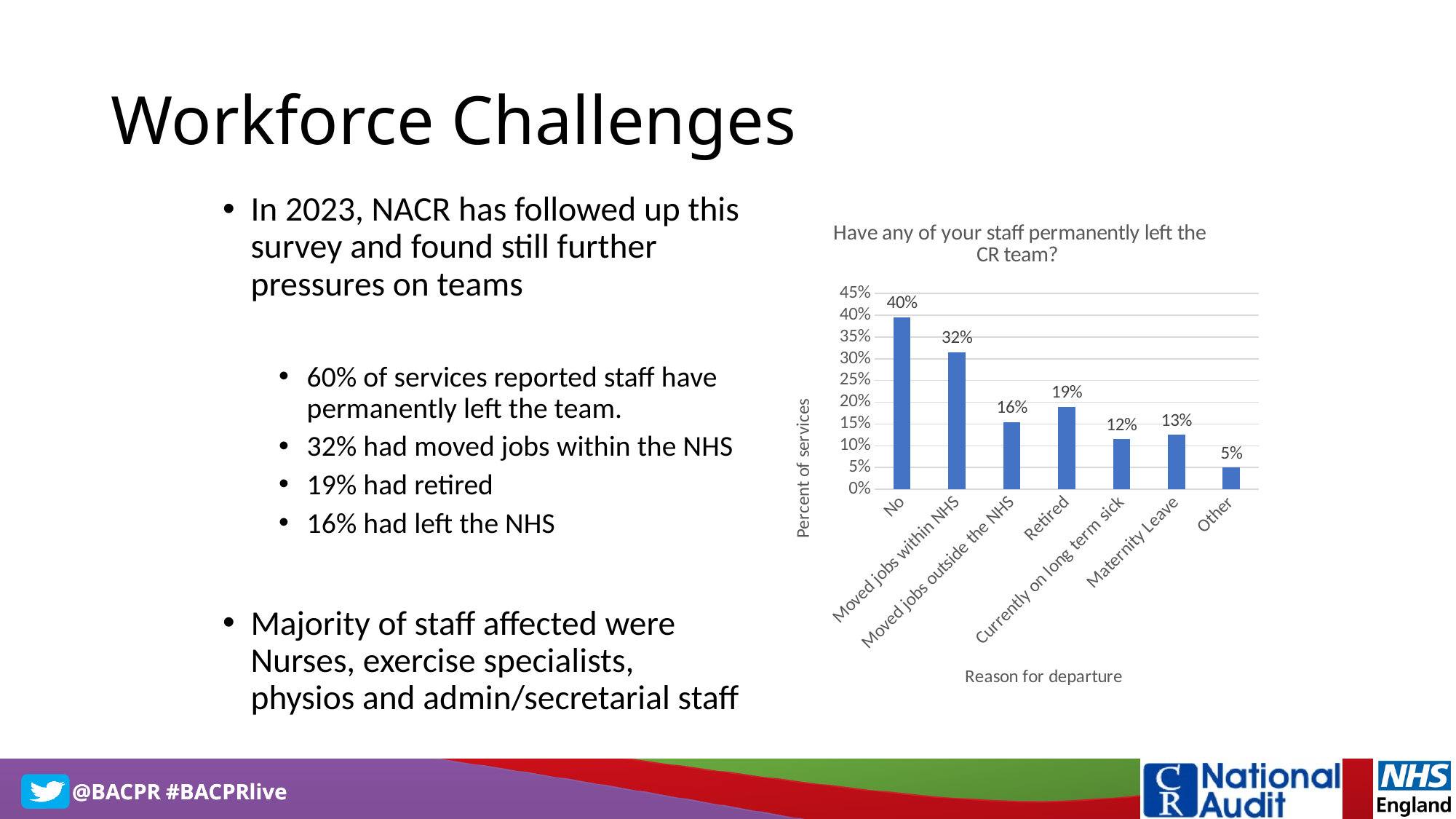
What is the value for "Maternity Leave"? 13% What is the value for "No" in the chart? 40% What is the title of the chart? Have any of your staff permanently left the CR team? Which category has the highest value in the chart? No What percentage of services reported staff had moved jobs within the NHS? 32% What is the value for "Retired"? 19% How many categories are shown on the x axis of the chart? 7 Which is larger: "Currently on long term sick" or "Maternity Leave"? Maternity Leave What kind of chart is shown on the slide? Bar chart What is the difference between "Moved jobs within NHS" and "Moved jobs outside the NHS"? 16% Which reason for departure has the lowest value? Other What is the label of the y axis of the chart? Percent of services